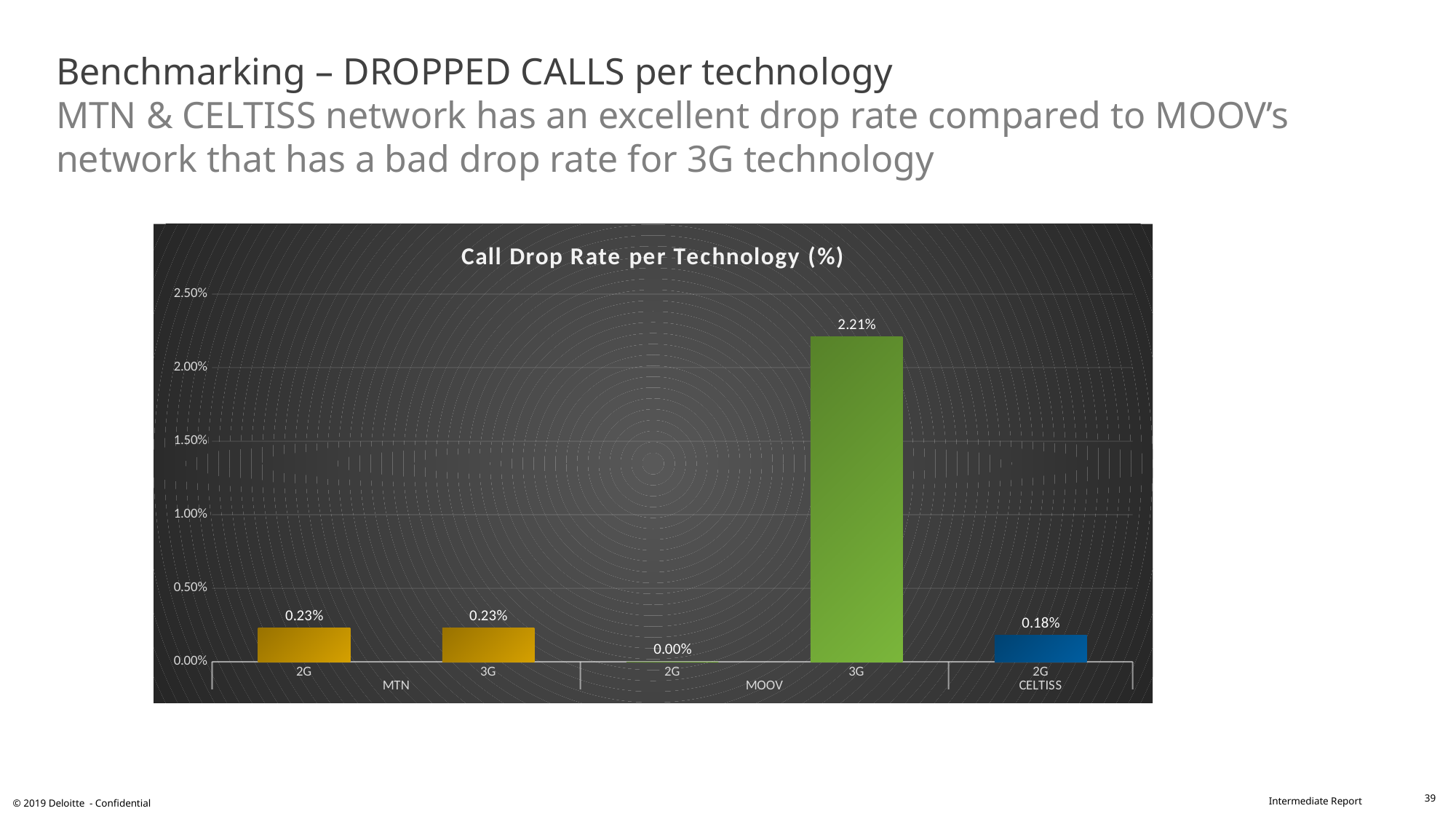
Is the call drop rate for MOOV 3G greater or less than 2.00%? greater What kind of chart is shown on the slide? bar chart What is the call drop rate for MTN 2G? 0.23% Which bar has the lowest call drop rate? MOOV 2G How many bars are plotted in the chart? 5 What is the difference between the call drop rate for MOOV 3G and MTN 3G? 1.98% What is the call drop rate for MOOV 3G? 2.21% What is the call drop rate for MOOV 2G? 0.00% What is the title of the chart? Call Drop Rate per Technology (%) What is the call drop rate for CELTISS 2G? 0.18% Which is larger, the call drop rate for MTN 2G or CELTISS 2G? MTN 2G Which bar has the highest call drop rate? MOOV 3G